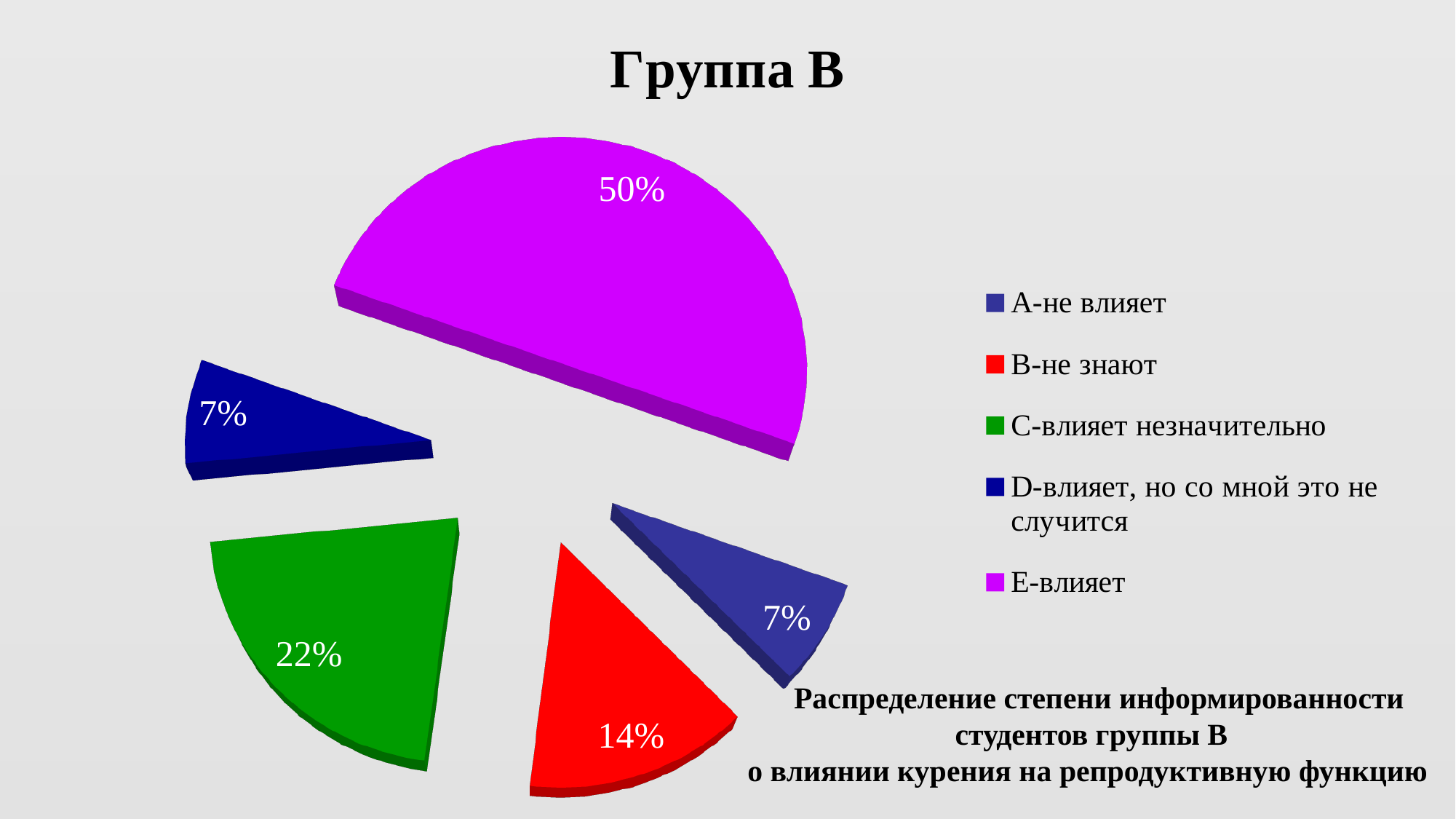
How many slices does the pie chart have? 5 Which category has the largest share of the pie? E-влияет What percentage is shown for the slice 'C-влияет незначительно'? 22% Which is larger: the share for 'B-не знают' or the share for 'C-влияет незначительно'? C-влияет незначительно What is the title of the chart? Группа В How many entries does the legend list? 5 What percentage is shown for the slice 'B-не знают'? 14% What type of chart is shown on the slide? Pie chart What percentage is shown for the slice 'E-влияет'? 50% What colour is the slice for 'E-влияет'? Magenta What percentage is shown for the slice 'A-не влияет'? 7% What is the difference in percentage points between 'E-влияет' and 'C-влияет незначительно'? 28